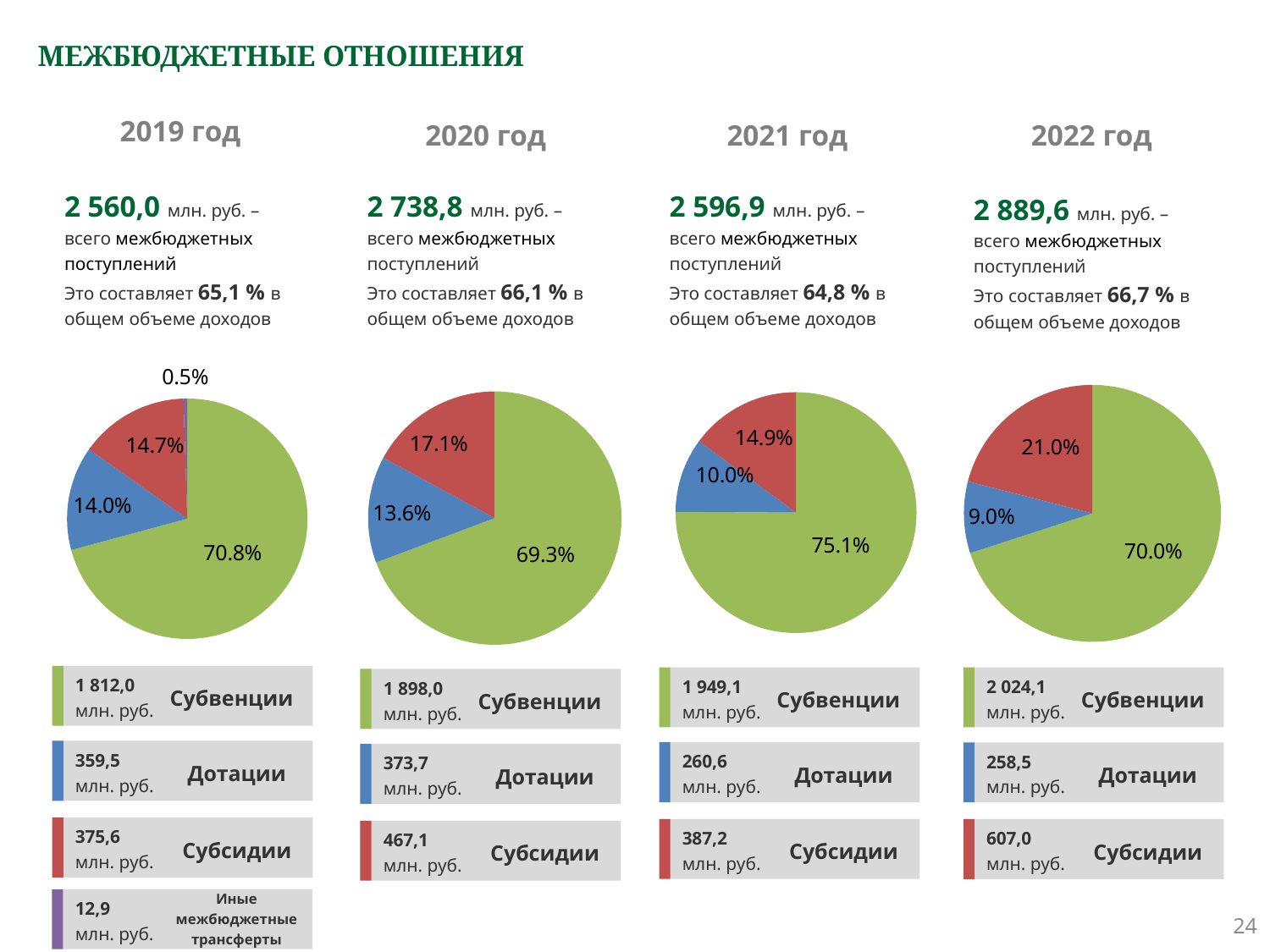
In the 2021 год pie chart, what share does the Дотации slice represent? 10.0% In the 2022 год pie chart, what share does the Субсидии slice represent? 21.0% In the 2020 год pie chart, which category has the largest slice? Субвенции In the 2022 год pie chart, which slice is larger: Дотации or Субсидии? Субсидии According to the legend of the 2022 год chart, what is the value for Субсидии? 607,0 млн. руб. What type of chart is used for the 2021 год data? Pie chart In the 2019 год pie chart, what share does the Субвенции slice represent? 70.8% How many slices does the 2022 год pie chart have? 3 According to the legend of the 2021 год chart, what is the value for Субвенции? 1 949,1 млн. руб. In the 2020 год pie chart, what is the difference in percentage points between the Субсидии slice (17.1%) and the Дотации slice (13.6%)? 3.5 percentage points In the 2019 год pie chart, which category has the smallest slice? Иные межбюджетные трансферты How many slices does the 2019 год pie chart have? 4